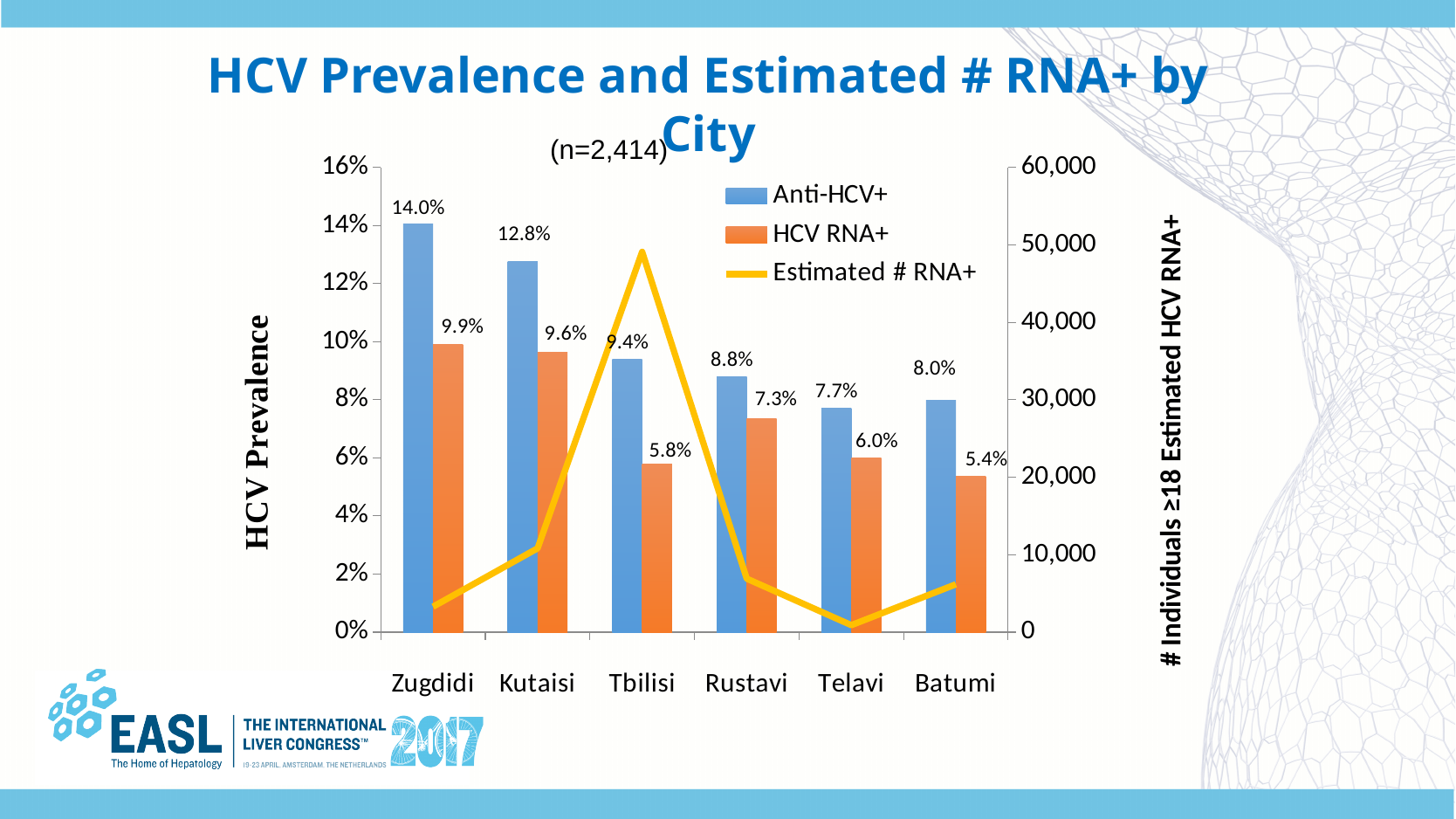
Which is larger, the HCV RNA+ prevalence in Rustavi or in Telavi? Rustavi Is the Estimated # RNA+ value for Tbilisi greater or less than 40,000? greater What is the Anti-HCV+ prevalence for Zugdidi? 14.0% How many series does the legend list? 3 Which city has the lowest HCV RNA+ prevalence? Batumi What is the HCV RNA+ prevalence for Batumi? 5.4% What is the difference between the Anti-HCV+ and HCV RNA+ prevalence in Kutaisi? 3.2% How many cities are shown on the x axis? 6 Which city has the highest Anti-HCV+ prevalence? Zugdidi What is the HCV RNA+ prevalence for Tbilisi? 5.8% Is the Estimated # RNA+ value for Telavi greater or less than 10,000? less What is the sample size (n) shown under the chart title? 2,414